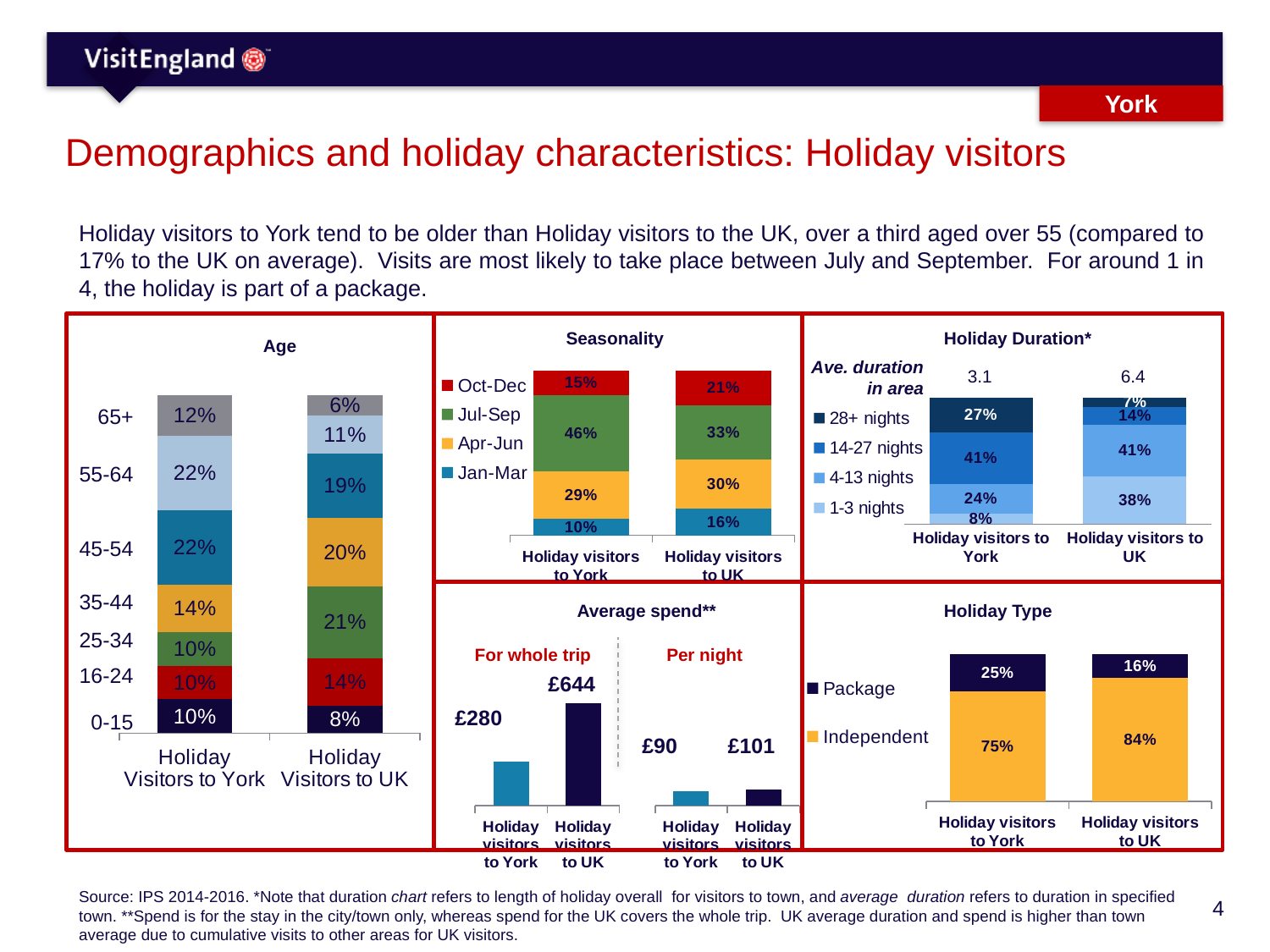
In the Age chart, what percentage of Holiday Visitors to UK are aged 25-34? 21% In the Average spend chart, what is the spend for the whole trip for Holiday visitors to UK? £644 In the Age chart, what percentage of Holiday Visitors to York are aged 65+? 12% What kind of chart is the Holiday Type chart? Stacked bar chart In the Holiday Duration chart, what percentage of Holiday visitors to UK stay 1-3 nights? 38% In the Holiday Duration chart, what is the average duration in area for Holiday visitors to York? 3.1 In the Holiday Type chart, what percentage of Holiday visitors to York are on a Package holiday? 25% In the Age chart, what is the difference between the 55-64 share for Holiday Visitors to York and for Holiday Visitors to UK? 11% In the Average spend chart, which is larger: the per night spend for Holiday visitors to York or for Holiday visitors to UK? Holiday visitors to UK In the Seasonality chart, what is the Oct-Dec share for Holiday visitors to UK? 21% In the Seasonality chart, how many series does the legend list? 4 In the Seasonality chart, which season has the highest share for Holiday visitors to York? Jul-Sep